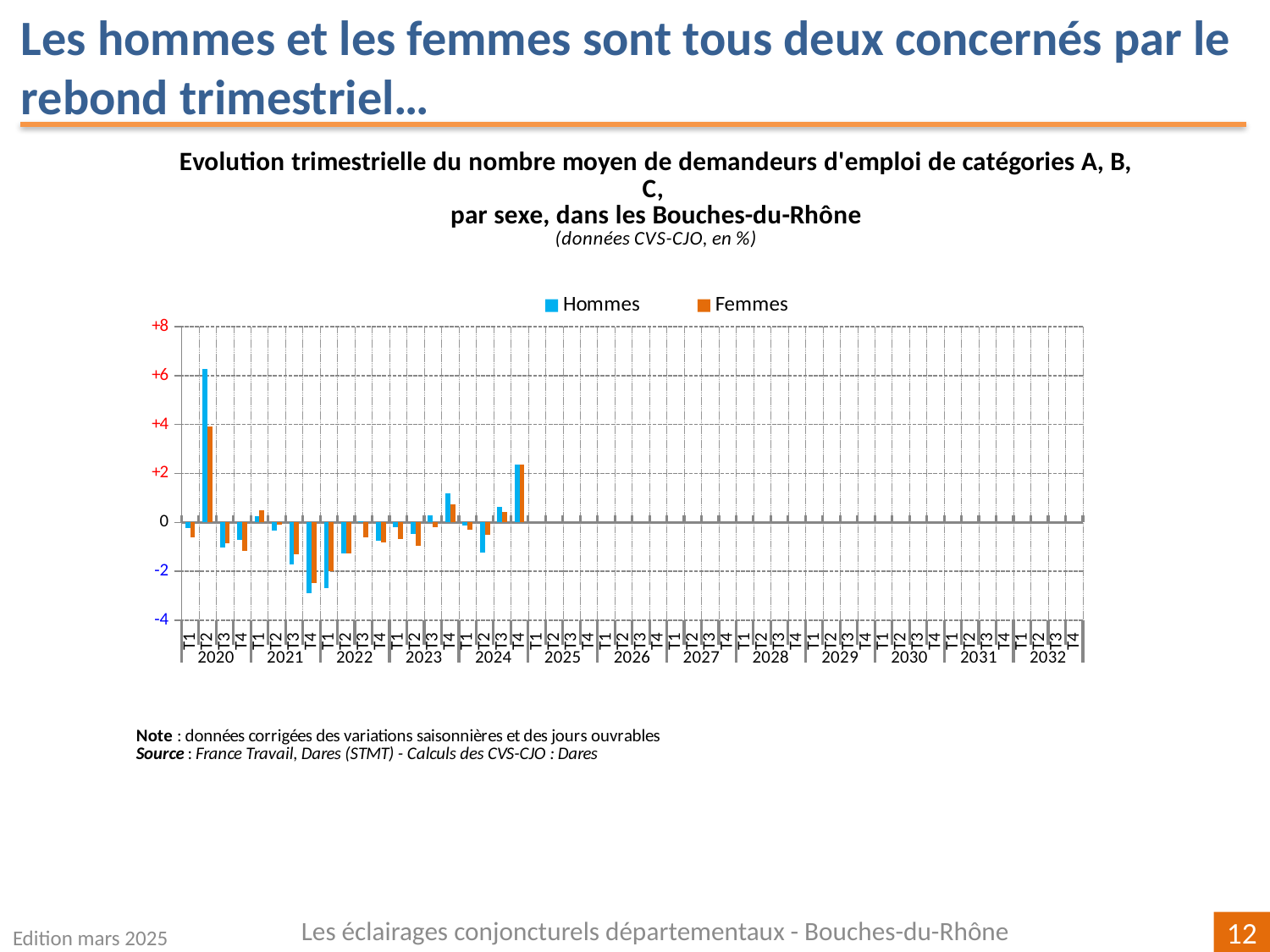
Which colour represents the Femmes series? orange Is the value for Hommes in T2 2020 greater or less than +4? greater In which quarter does the Hommes series reach its lowest value? T4 2021 In which quarter does the Hommes series reach its highest value? T2 2020 Is the value for Hommes in T4 2021 greater or less than -2? less In which quarter does the Femmes series reach its highest value? T2 2020 What are the two series named in the legend? Hommes and Femmes In T4 2023, which series has the larger value, Hommes or Femmes? Hommes Is the value for Femmes in T2 2020 greater or less than +2? greater In T2 2020, which series has the larger value, Hommes or Femmes? Hommes How many series does the legend list? 2 What kind of chart is shown on the slide? bar chart